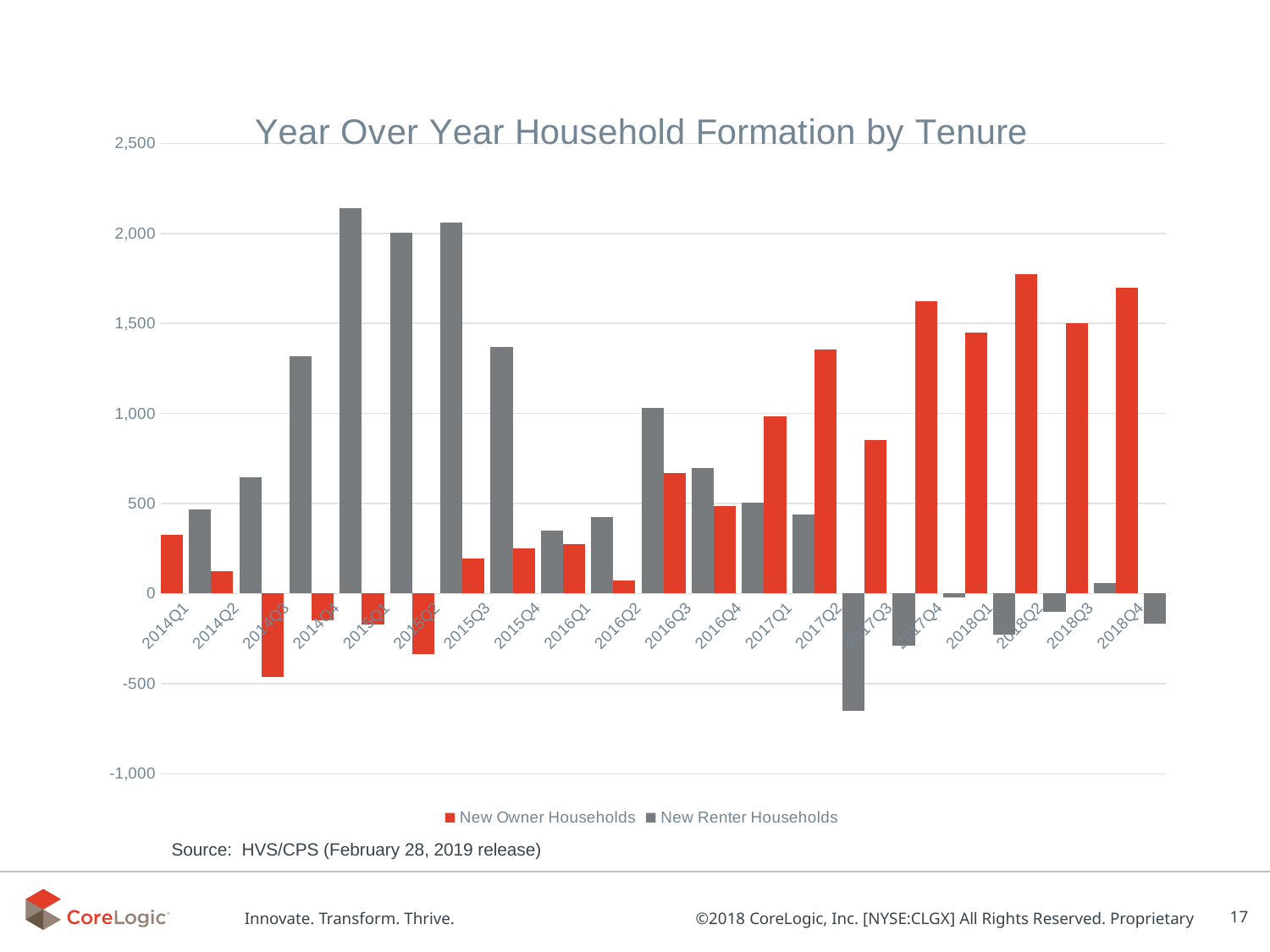
Is the New Renter Households value for 2017Q2 greater or less than -500? less Which colour represents New Renter Households in the chart? Gray How many series does the legend list? 2 How many quarters are shown along the x axis? 20 In which quarter is the New Renter Households value highest? 2014Q4 Is the New Renter Households value for 2014Q4 greater or less than 2,000? greater In which quarter is the New Owner Households value lowest? 2014Q3 In which quarter is the New Renter Households value lowest? 2017Q2 What is the title of the chart? Year Over Year Household Formation by Tenure In 2018Q2, which is larger: New Owner Households or New Renter Households? New Owner Households What kind of chart is shown on the slide? Bar chart Is the New Owner Households value for 2018Q2 greater or less than 1,500? greater